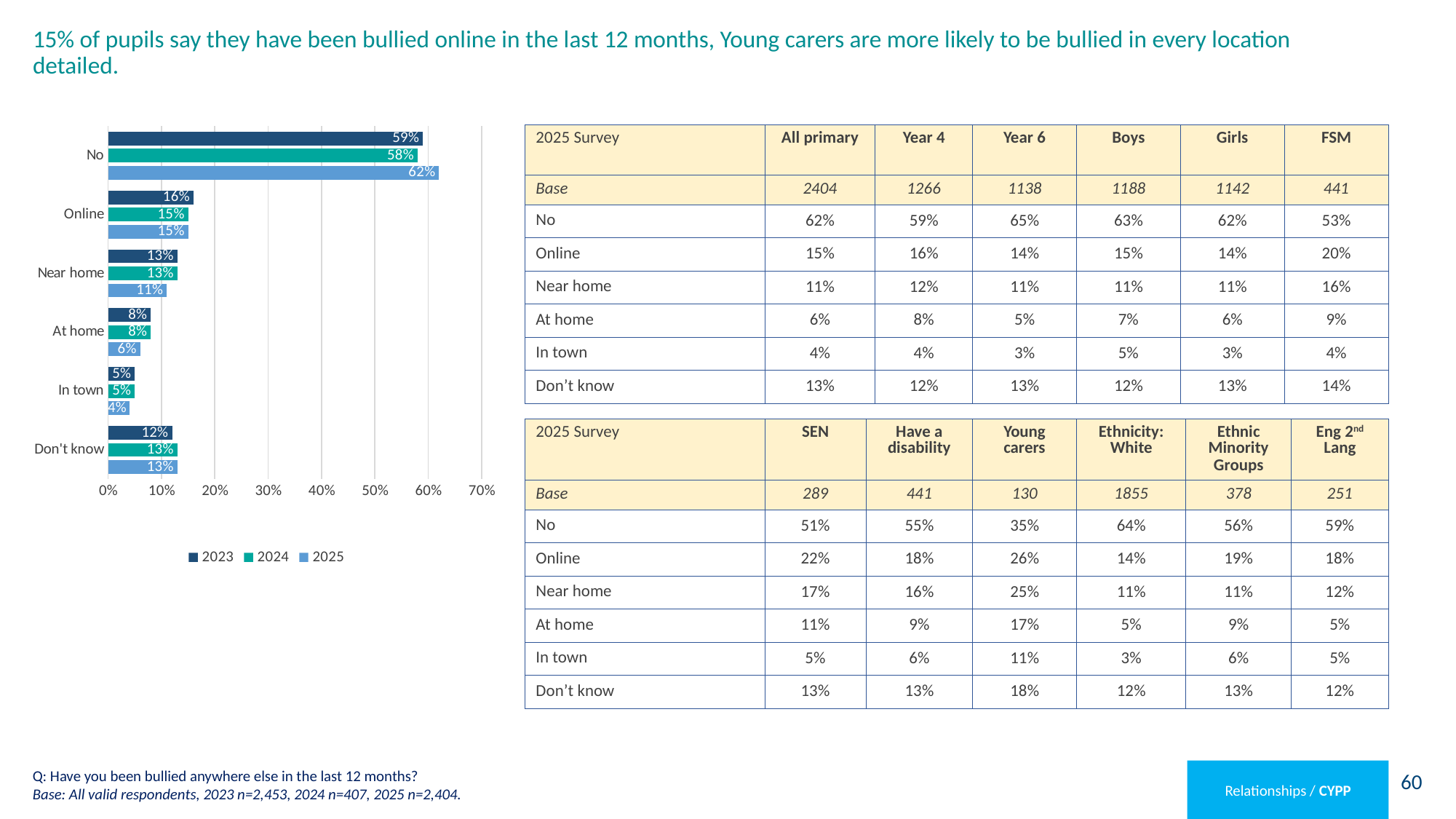
Which is larger in the bar chart: the 2025 value for 'Near home' or the 2025 value for 'Don't know'? Don't know What is the 2025 value for 'In town' in the bar chart? 4% How many series does the legend of the bar chart list? 3 What is the 2024 value for 'Near home' in the bar chart? 13% What is the 2025 value for 'No' in the bar chart? 62% Which category has the highest 2025 value in the bar chart? No Which category has the lowest 2023 value in the bar chart? In town What are the series names listed in the legend of the bar chart? 2023, 2024, 2025 How many categories are shown on the bar chart? 6 What is the difference between the 2025 and 2023 values for 'No' in the bar chart? 3% What kind of chart is shown on the slide? Bar chart What is the 2023 value for 'Online' in the bar chart? 16%